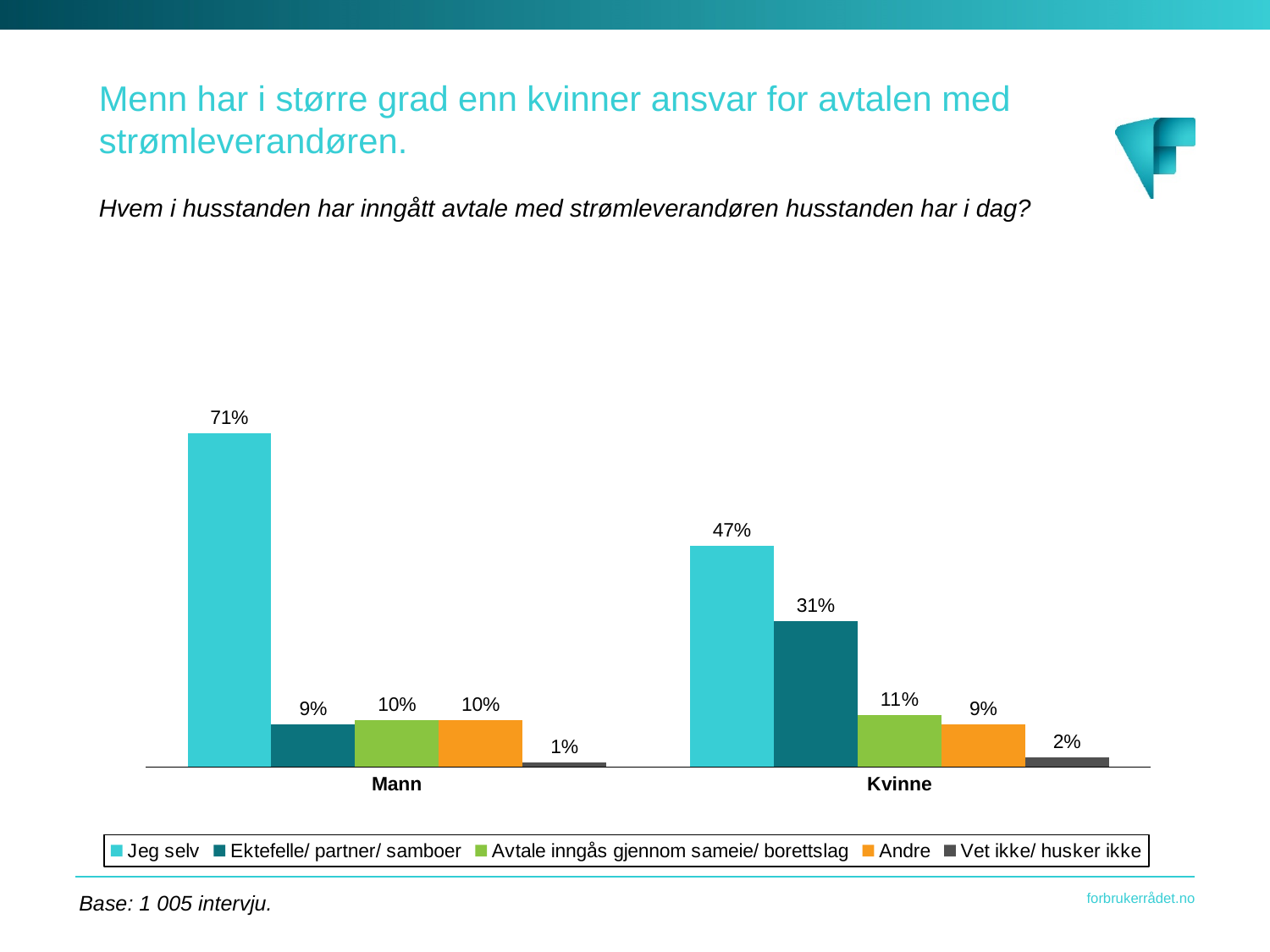
What is the value for "Andre" in the Mann group? 10% What percentage of men answered "Jeg selv"? 71% Which response has the highest value in the Kvinne group? Jeg selv What kind of chart is shown on the slide? Bar chart What is the value for "Vet ikke/ husker ikke" in the Kvinne group? 2% How many series does the legend list? 5 What is the difference between the "Jeg selv" values for Mann and Kvinne? 24 percentage points Which group has the larger value for "Avtale inngås gjennom sameie/ borettslag", Mann or Kvinne? Kvinne Which response has the lowest value in the Mann group? Vet ikke/ husker ikke What percentage of women answered "Ektefelle/ partner/ samboer"? 31% What is the difference between the "Ektefelle/ partner/ samboer" values for Kvinne and Mann? 22 percentage points How many categories are shown on the x axis? 2